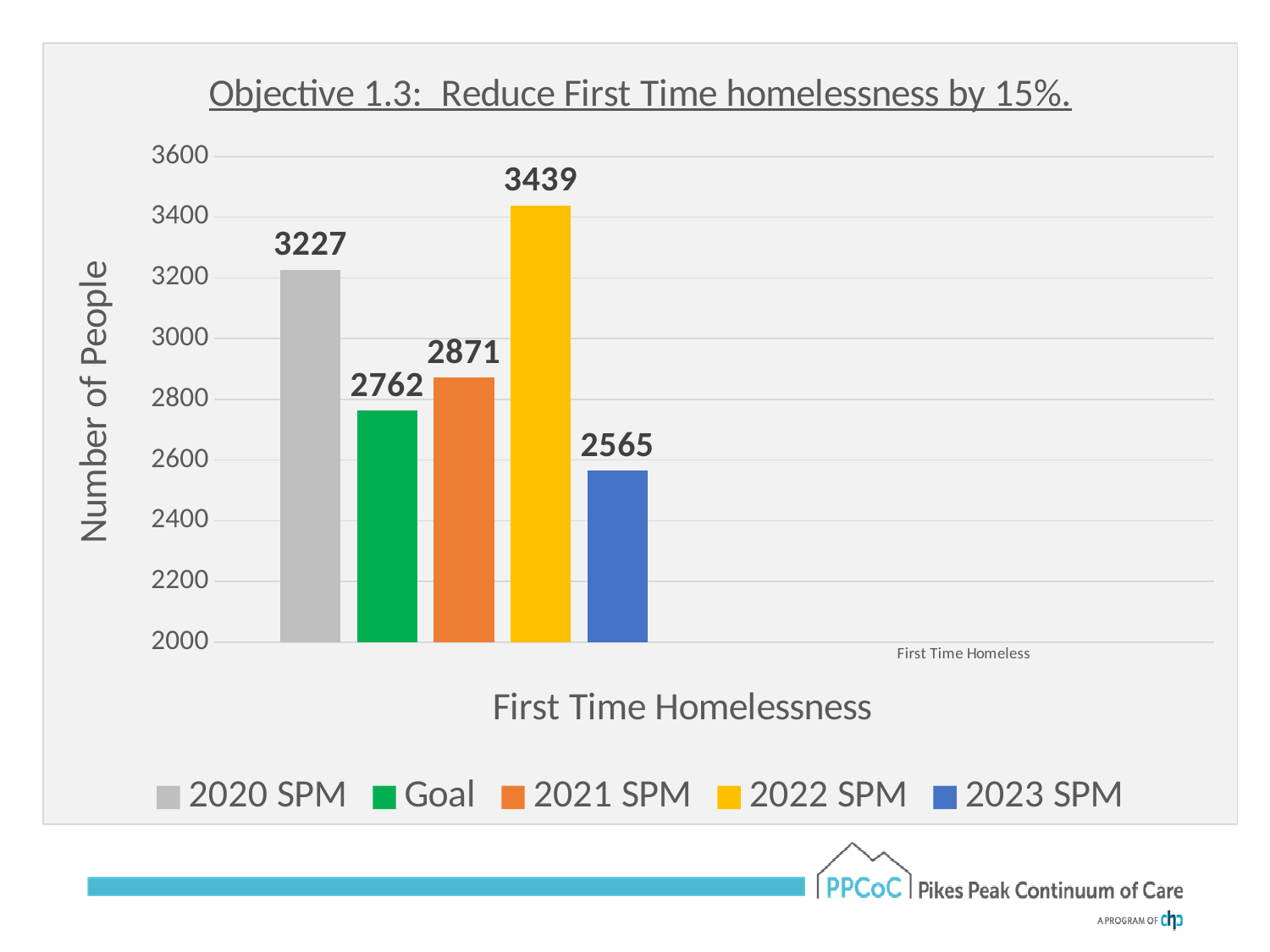
What is the value for the Goal series? 2762 Which is larger, the 2021 SPM value or the Goal value? 2021 SPM What is the difference between the 2020 SPM value and the Goal value? 465 What is the value for 2021 SPM? 2871 How many series does the legend list? 5 What is the title of the chart? Objective 1.3: Reduce First Time homelessness by 15%. What is the value for 2020 SPM? 3227 What kind of chart is shown on the slide? Bar chart What is the difference between the 2022 SPM value and the 2023 SPM value? 874 Which series has the highest value? 2022 SPM Which series has the lowest value? 2023 SPM What is the value for 2023 SPM? 2565